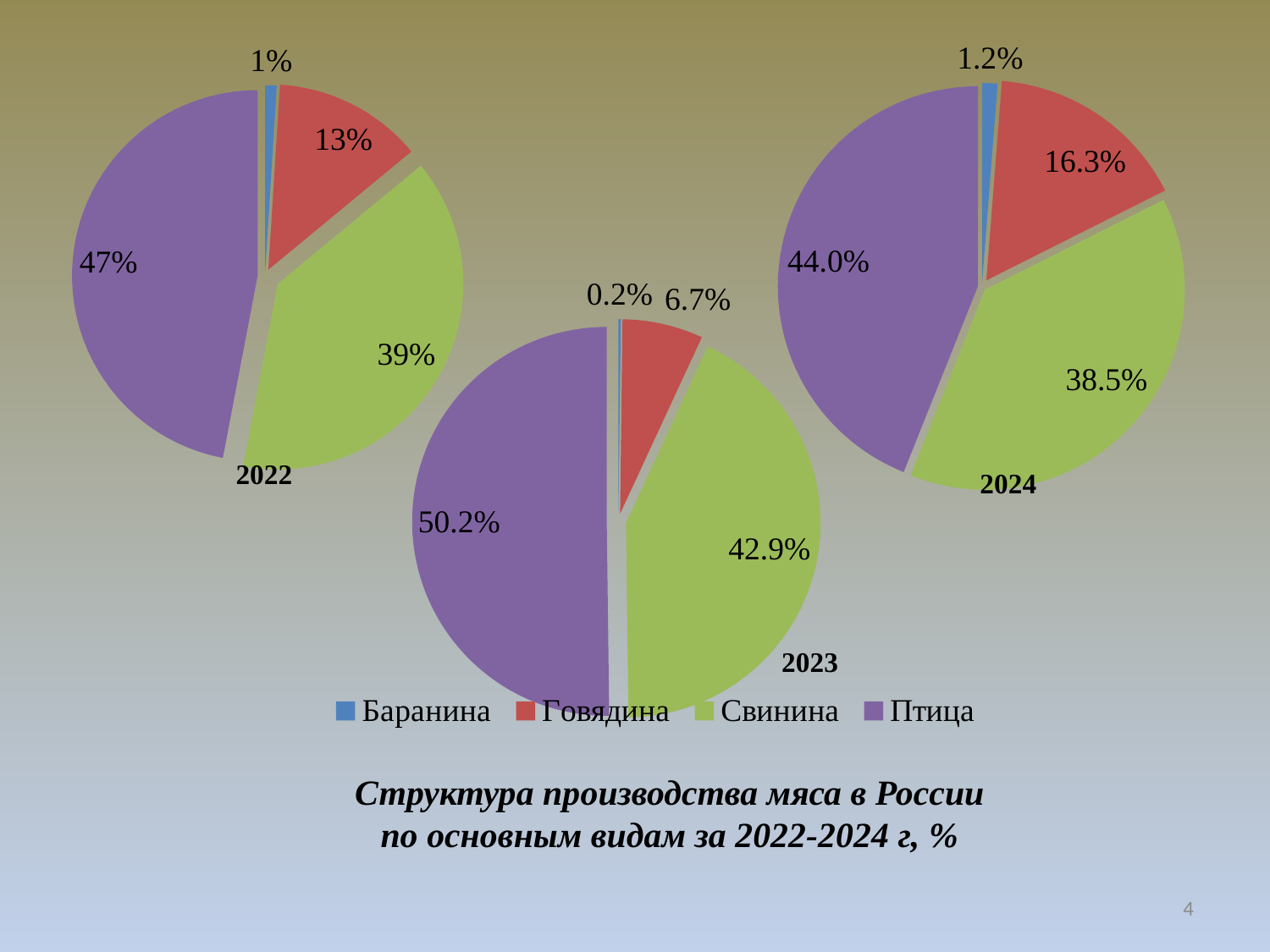
In the 2024 pie chart, what share does Говядина have? 16.3% In the 2022 pie chart, which category has the smallest share? Баранина How many pie charts are on the slide? 3 In the 2024 pie chart, what is the difference between the shares of Птица and Свинина? 5.5% What kind of charts are shown on the slide? Pie charts How many categories does the legend list for the pie charts? 4 In the 2023 pie chart, which is larger: the share of Говядина or the share of Свинина? Свинина In the 2023 pie chart, what share does Баранина have? 0.2% In the 2023 pie chart, what share does Свинина have? 42.9% In the 2022 pie chart, what share does Птица have? 47% In the 2024 pie chart, which category has the largest share? Птица Which colour represents Свинина in the pie charts? Green